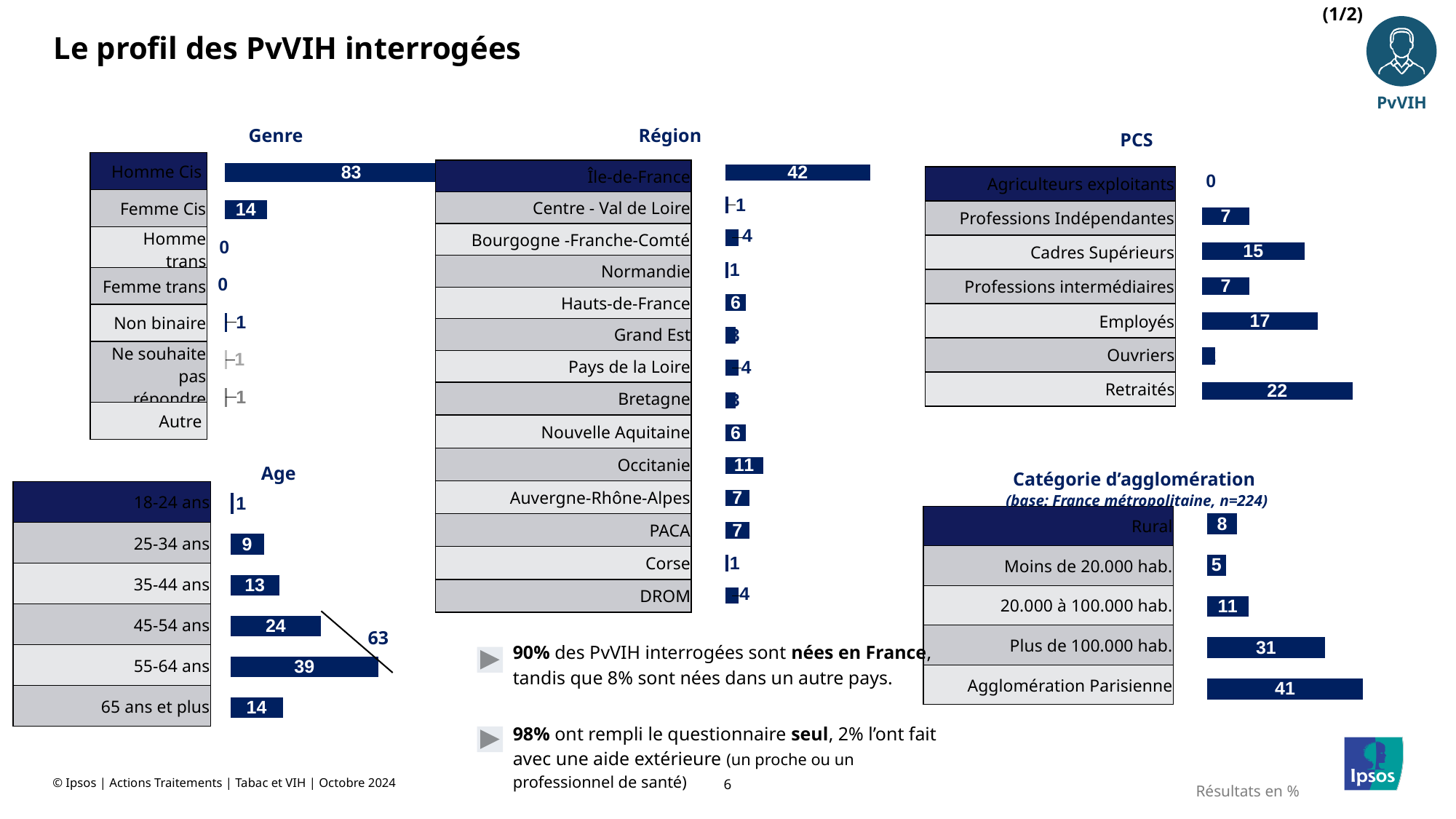
In the Région chart, which region has the highest value? Île-de-France In the PCS chart, which category has the highest value? Retraités In the Genre chart, what is the value for Homme Cis? 83 In the Age chart, which age group has the highest value? 55-64 ans In the Catégorie d'agglomération chart, what is the value for Agglomération Parisienne? 41 In the Catégorie d'agglomération chart, which is larger: Plus de 100.000 hab. or 20.000 à 100.000 hab.? Plus de 100.000 hab. What kind of chart is the Age chart? bar chart In the Genre chart, what is the value for Femme Cis? 14 In the PCS chart, what is the difference between Employés and Cadres Supérieurs? 2 In the PCS chart, what is the value for Agriculteurs exploitants? 0 In the Région chart, how many regions are listed? 14 In the Région chart, what is the value for Occitanie? 11